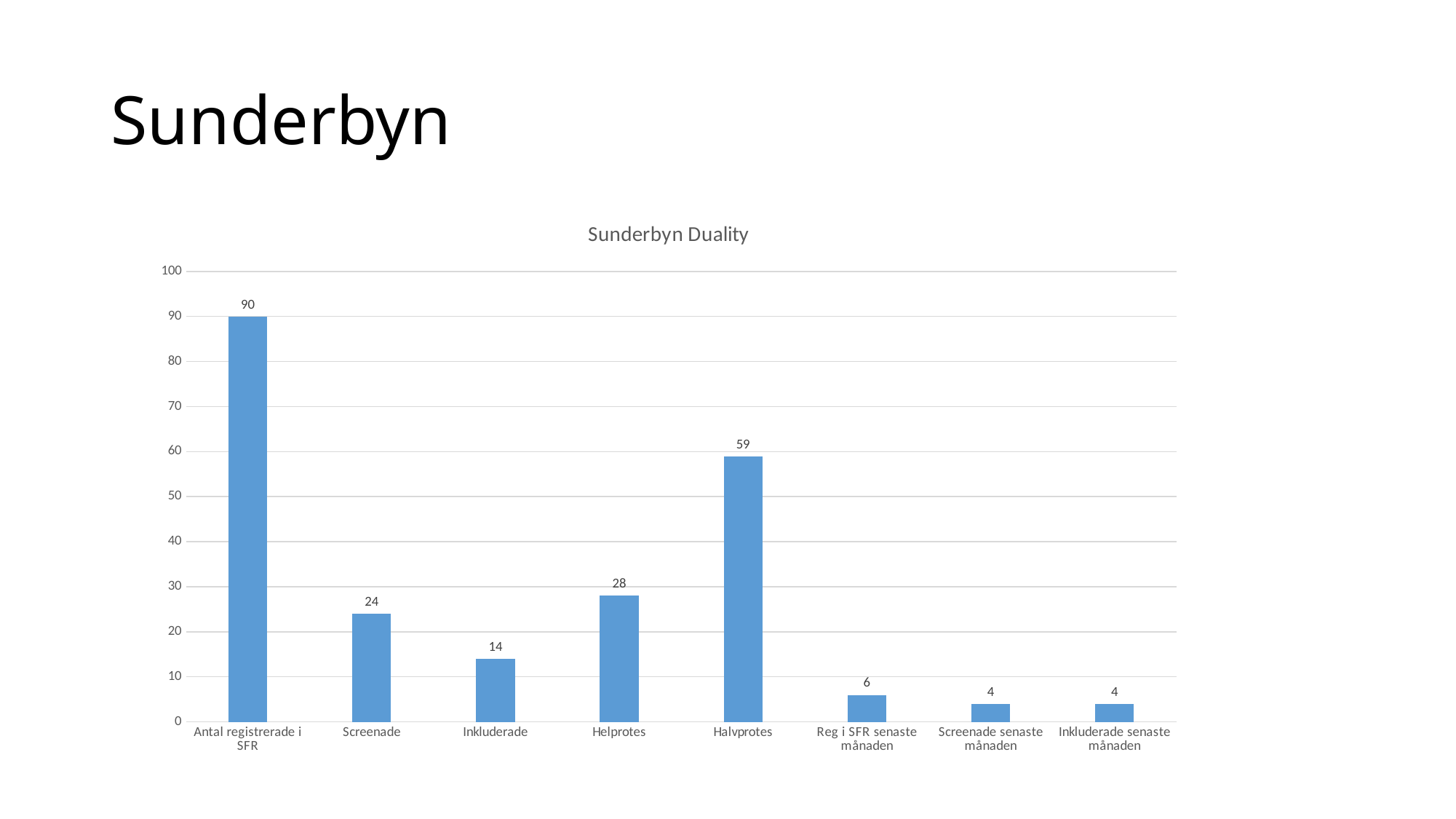
Which category has the highest value? Antal registrerade i SFR What is the value for Reg i SFR senaste månaden? 6 What is the value for Inkluderade? 14 What is the difference between the values for Halvprotes and Helprotes? 31 What kind of chart is shown on the slide? bar chart What is the value for Antal registrerade i SFR? 90 What is the title of the chart? Sunderbyn Duality Is the value for Halvprotes greater or less than 50? greater What is the difference between the values for Screenade and Inkluderade? 10 How many categories are shown on the chart? 8 What is the value for Halvprotes? 59 Which is larger, the value for Helprotes or the value for Screenade? Helprotes